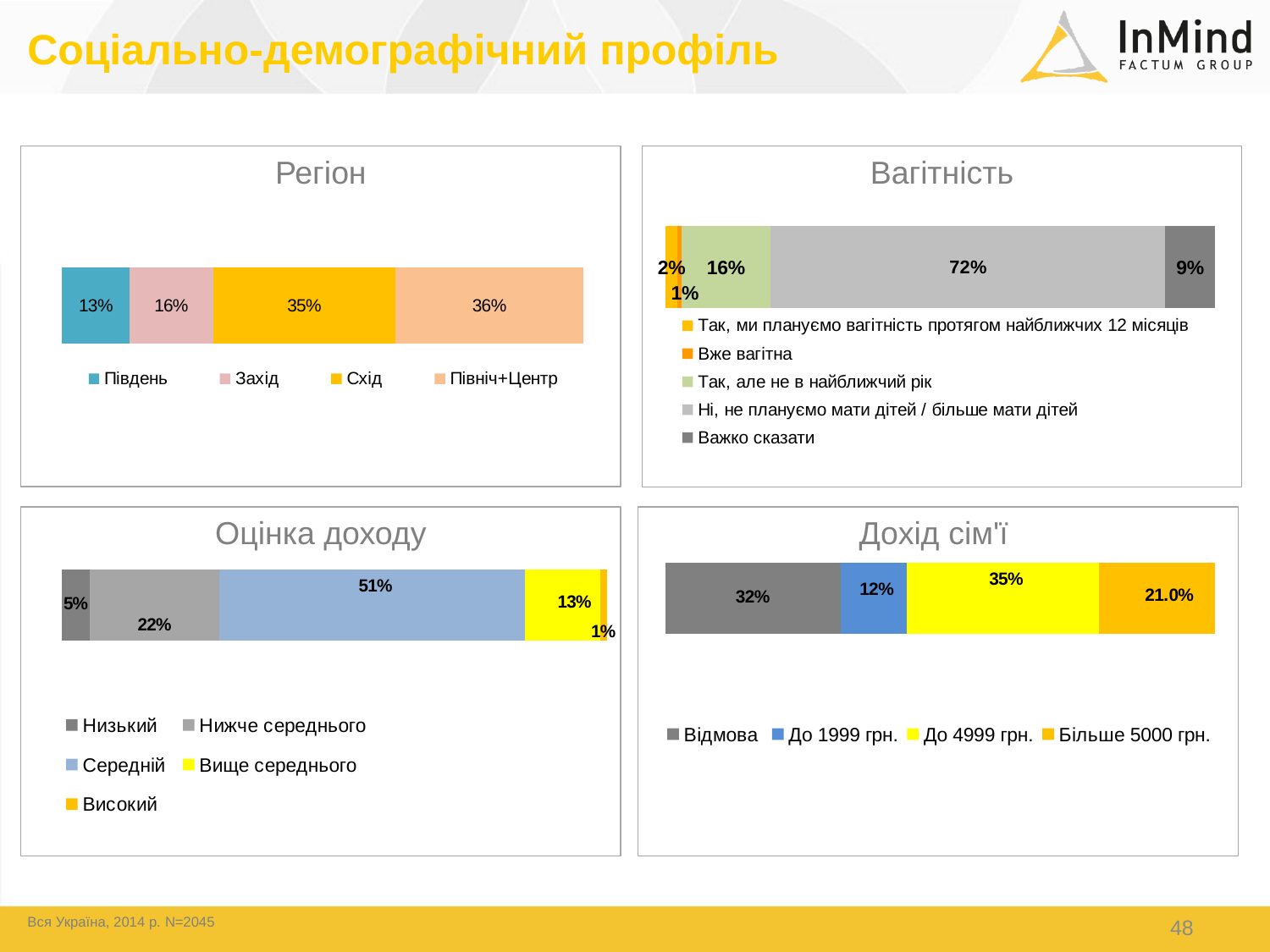
In the 'Вагітність' chart, what is the value for 'Важко сказати'? 9% What type of chart is used in the 'Дохід сім'ї' panel? Stacked bar chart In the 'Регіон' chart, what is the difference between Північ+Центр and Захід? 20% In the 'Оцінка доходу' chart, what is the value for Середній? 51% In the 'Регіон' chart, which region has the lowest share? Південь In the 'Дохід сім'ї' chart, which is larger: Відмова or До 4999 грн.? До 4999 грн. In the 'Вагітність' chart, what is the value for 'Ні, не плануємо мати дітей / більше мати дітей'? 72% In the 'Регіон' chart, how many regions are shown in the legend? 4 In the 'Оцінка доходу' chart, which category has the largest share? Середній In the 'Дохід сім'ї' chart, what is the value for 'Більше 5000 грн.'? 21.0% In the 'Вагітність' chart, how many categories does the legend list? 5 In the 'Регіон' chart, what is the value for Схід? 35%